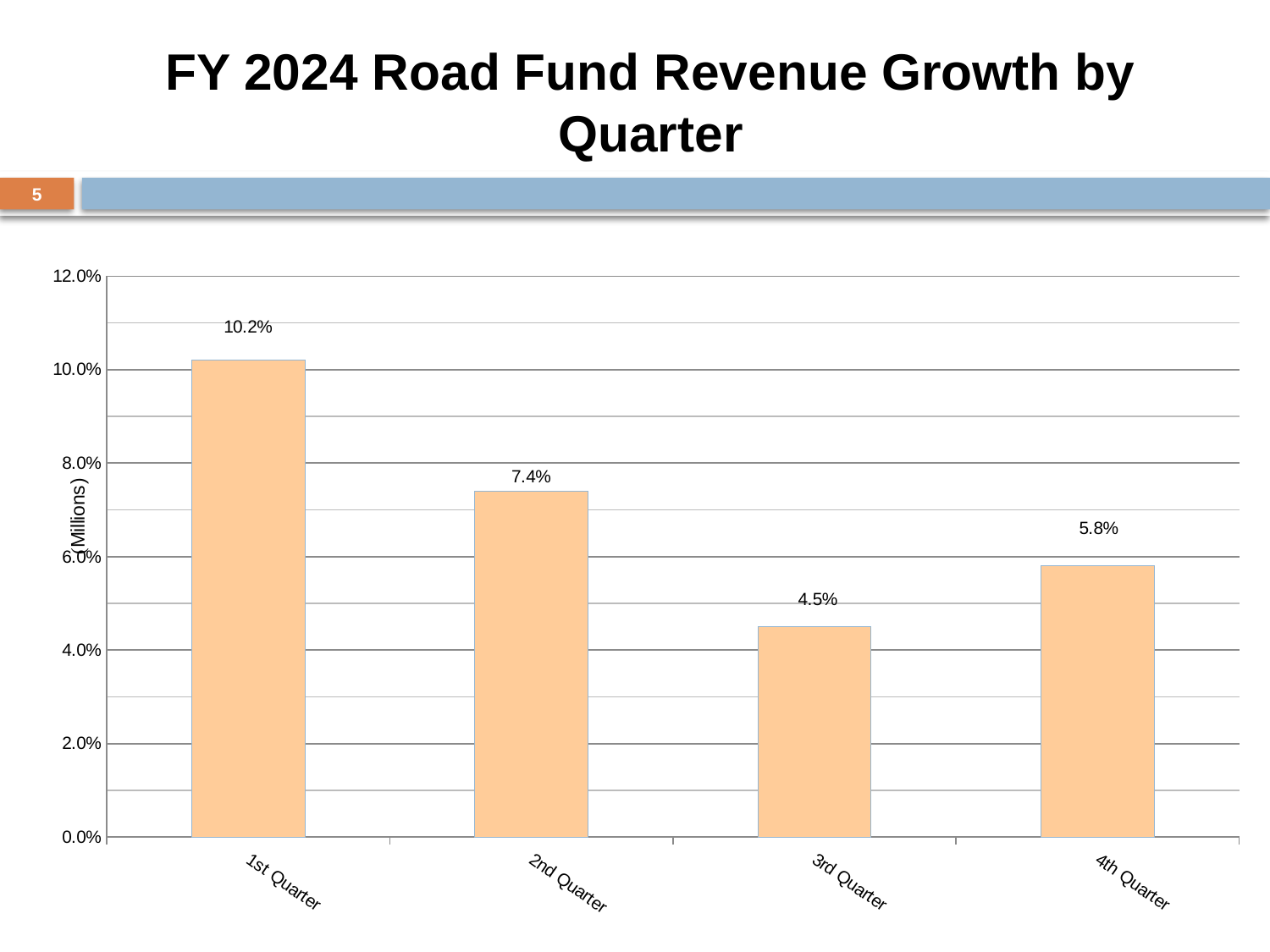
What kind of chart is shown on the slide? Bar chart What is the difference between the values for 1st Quarter and 2nd Quarter? 2.8% How many quarters are shown on the chart? 4 What is the difference between the values for 4th Quarter and 3rd Quarter? 1.3% What is the value for 2nd Quarter? 7.4% Which quarter has the highest value? 1st Quarter Which quarter has the lowest value? 3rd Quarter What is the value for 3rd Quarter? 4.5% What is the title of the chart on the slide? FY 2024 Road Fund Revenue Growth by Quarter What is the value for 1st Quarter? 10.2% What is the value for 4th Quarter? 5.8% Which is larger, the value for 2nd Quarter or the value for 4th Quarter? 2nd Quarter